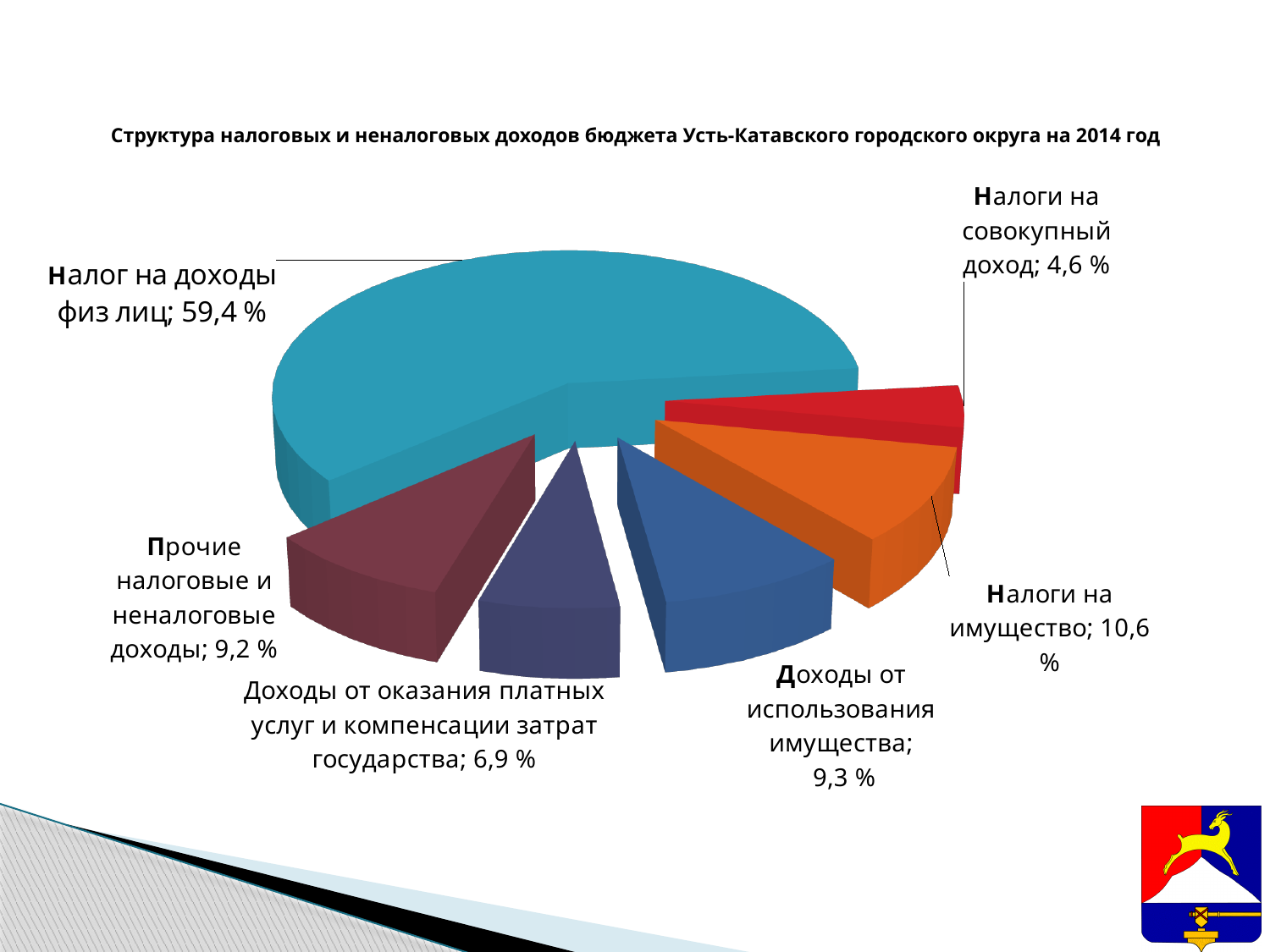
How many slices does the pie chart have? 6 Which category has the smallest slice of the pie chart? Налоги на совокупный доход What type of chart is shown on the slide? Pie chart Which category has the largest slice of the pie chart? Налог на доходы физ лиц What is the share of "Налоги на имущество" in the pie chart? 10,6 % What is the share of "Прочие налоговые и неналоговые доходы" in the pie chart? 9,2 % What is the difference in percentage points between "Налог на доходы физ лиц" and "Налоги на имущество"? 48,8 What is the share of "Налог на доходы физ лиц" in the pie chart? 59,4 % What is the share of "Доходы от оказания платных услуг и компенсации затрат государства" in the pie chart? 6,9 % Which is larger: the share of "Налоги на имущество" or the share of "Налоги на совокупный доход"? Налоги на имущество What is the share of "Доходы от использования имущества" in the pie chart? 9,3 % What is the share of "Налоги на совокупный доход" in the pie chart? 4,6 %